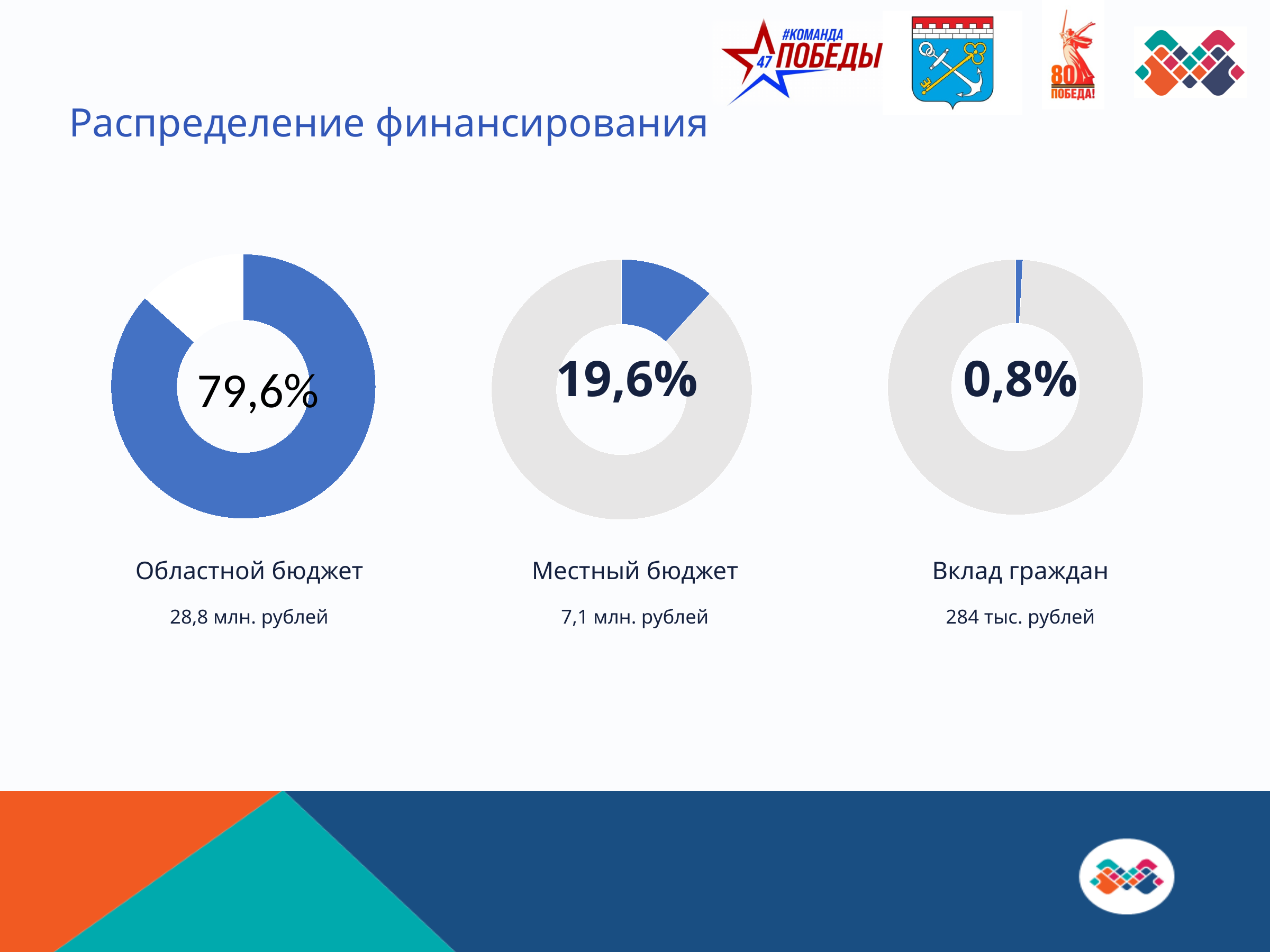
What amount in rubles is given under the Местный бюджет chart? 7,1 млн. рублей Which is larger: the share for Местный бюджет or the share for Вклад граждан? Местный бюджет How many donut charts are shown on the slide? 3 Which funding source has the largest share on the slide? Областной бюджет What percentage is shown in the donut chart for Областной бюджет? 79,6% By how many percentage points does the Областной бюджет share exceed the Местный бюджет share? 60 percentage points What amount in rubles is given under the Вклад граждан chart? 284 тыс. рублей What amount in rubles is given under the Областной бюджет chart? 28,8 млн. рублей What is the title of the slide containing the three donut charts? Распределение финансирования What percentage is shown in the donut chart for Вклад граждан? 0,8% Which funding source has the smallest share on the slide? Вклад граждан What percentage is shown in the donut chart for Местный бюджет? 19,6%